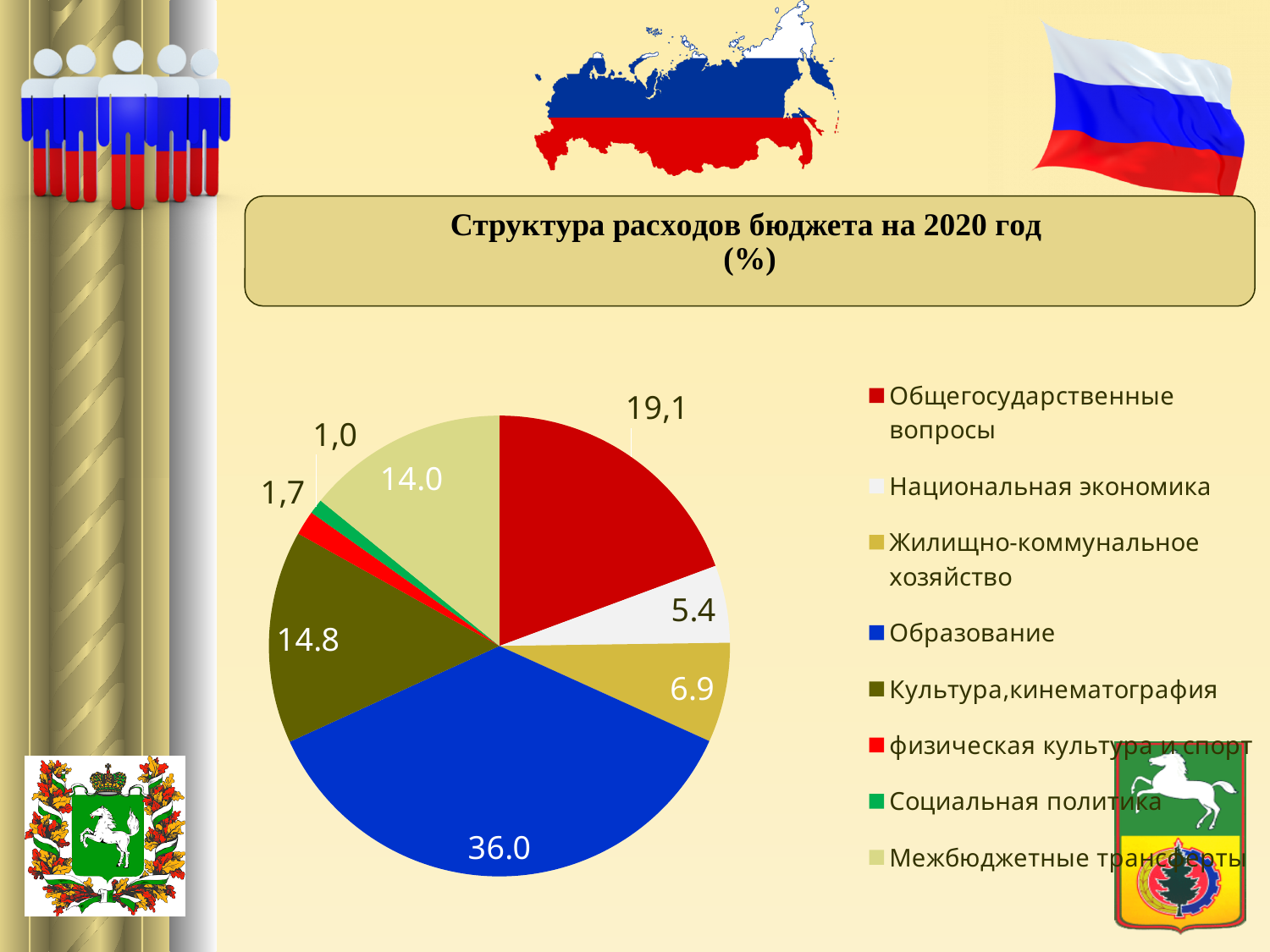
What is the value for Жилищно-коммунальное хозяйство? 6.9 What is the value for Культура,кинематография? 14.8 Which category has the largest slice of the pie? Образование What is the title of the chart? Структура расходов бюджета на 2020 год (%) What is the value for Общегосударственные вопросы? 19,1 Which is larger, the value for Национальная экономика or the value for Жилищно-коммунальное хозяйство? Жилищно-коммунальное хозяйство What is the difference between the values for Образование and Общегосударственные вопросы? 16.9 What is the value for Образование? 36.0 Which category has the smallest slice of the pie? Социальная политика What is the value for Социальная политика? 1,0 How many categories does the legend list? 8 What kind of chart is shown on the slide? pie chart